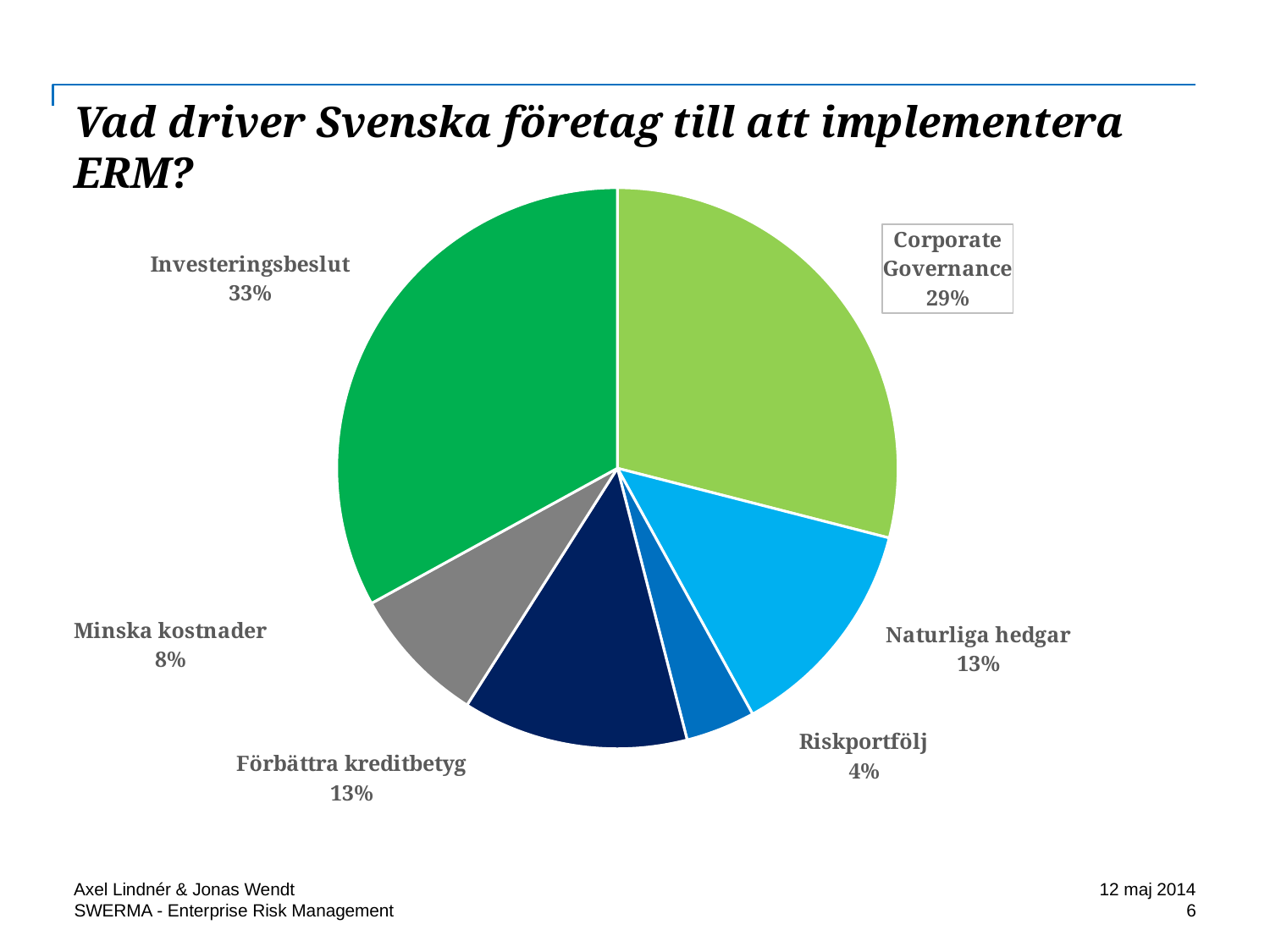
Which is larger, the share for Minska kostnader or the share for Förbättra kreditbetyg? Förbättra kreditbetyg What share of the pie does Corporate Governance have? 29% What is the title of the slide containing the pie chart? Vad driver Svenska företag till att implementera ERM? What is the value shown for Minska kostnader? 8% What is the value shown for Riskportfölj? 4% What kind of chart is shown on the slide? pie chart What is the value shown for Naturliga hedgar? 13% Which category has the largest slice of the pie? Investeringsbeslut What is the difference in percentage points between Investeringsbeslut and Corporate Governance? 4 Which category has the smallest slice of the pie? Riskportfölj What share of the pie does Investeringsbeslut have? 33% How many categories are shown in the pie chart? 6